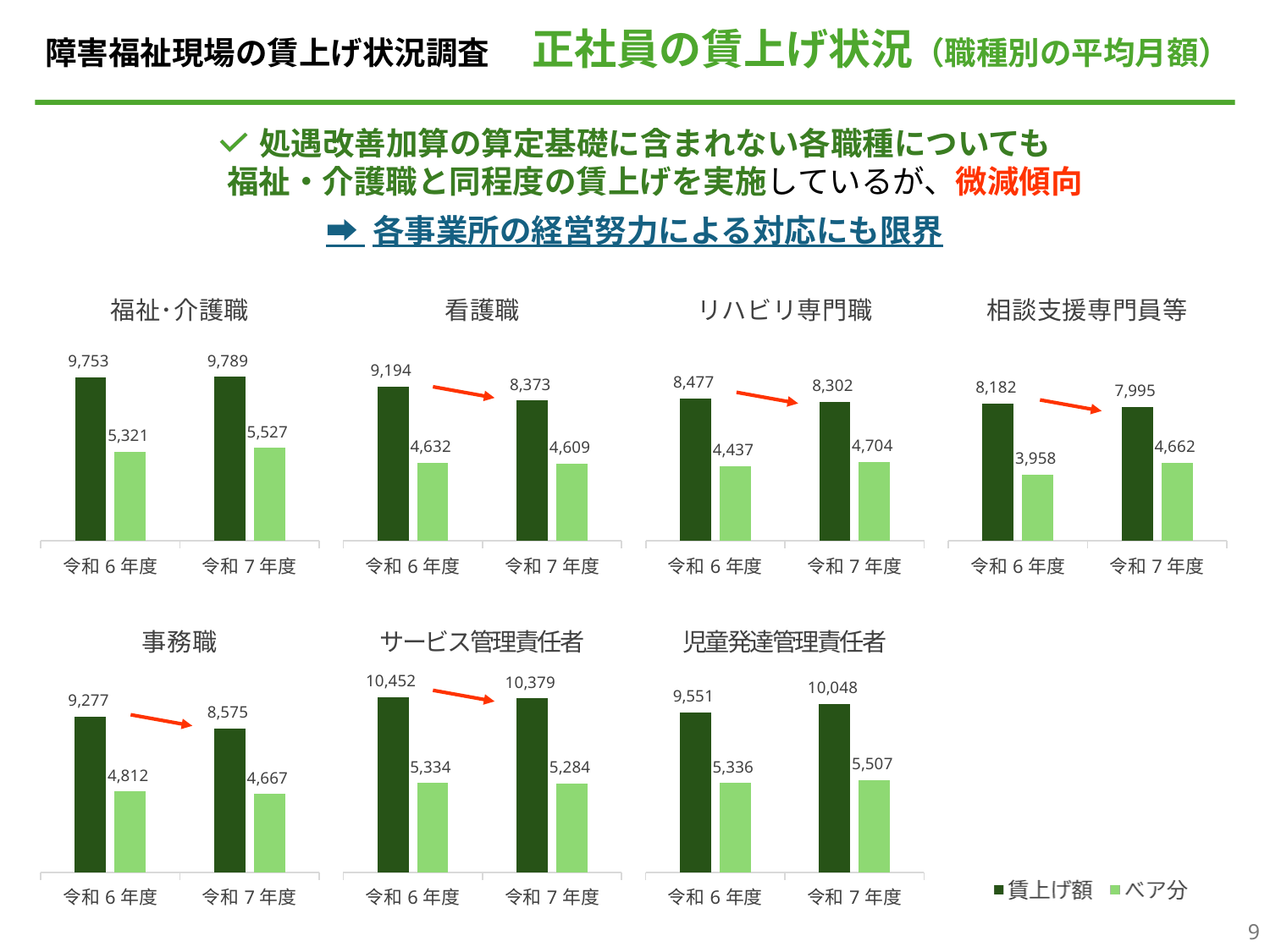
In the リハビリ専門職 chart, what is the difference in ベア分 between 令和７年度 and 令和６年度? 267 In the 事務職 chart, what is the difference in 賃上げ額 between 令和６年度 and 令和７年度? 702 Which series is shown in dark green in the charts on this slide? 賃上げ額 In the サービス管理責任者 chart, which year has the higher 賃上げ額, 令和６年度 or 令和７年度? 令和６年度 In the 看護職 chart, what is the ベア分 value for 令和６年度? 4,632 How many series does the legend list for the charts on this slide? 2 How many categories (years) are shown on the x axis of the 福祉・介護職 chart? 2 In the 福祉・介護職 chart, what is the 賃上げ額 value for 令和７年度? 9,789 In the 看護職 chart, does the 賃上げ額 rise or fall from 令和６年度 to 令和７年度? fall In the 児童発達管理責任者 chart, does the 賃上げ額 rise or fall from 令和６年度 to 令和７年度? rise In the 相談支援専門員等 chart, what is the 賃上げ額 value for 令和６年度? 8,182 What kind of chart is the 事務職 chart? bar chart